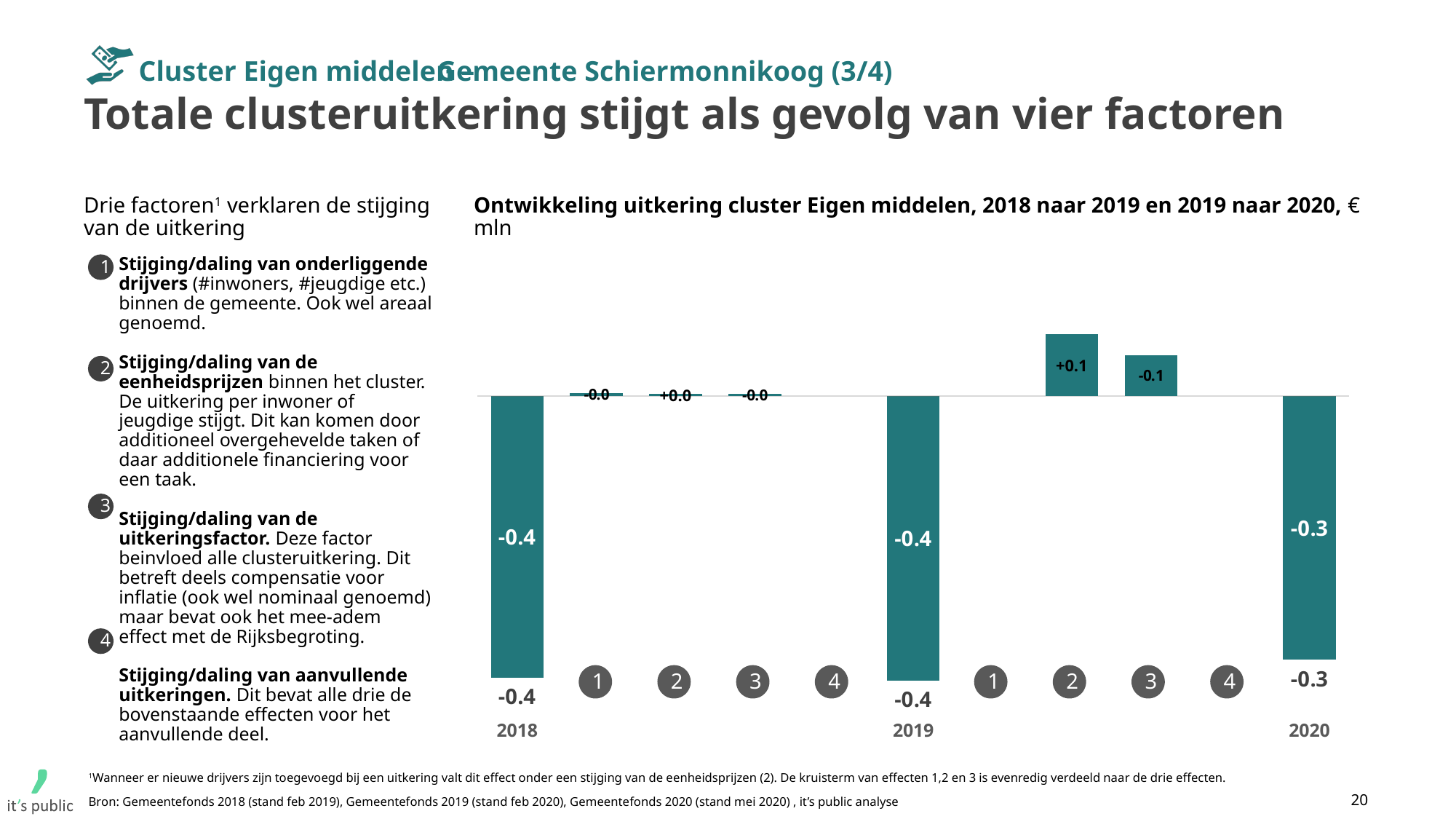
What is the value labelled for factor 2 in the 2018 to 2019 step of the chart? +0.0 What is the value of the 2019 bar in the chart? -0.4 What kind of chart is shown on the slide? Bar chart What is the value of the 2018 bar in the chart? -0.4 What is the value labelled for factor 2 in the 2019 to 2020 step of the chart? +0.1 What unit is stated in the chart title? € mln What is the value labelled for factor 3 in the 2019 to 2020 step of the chart? -0.1 What is the difference between the 2020 value and the 2019 value in the chart? 0.1 Which year bar in the chart has the highest value? 2020 How many year bars (2018, 2019, 2020) are shown in the chart? 3 Which is larger in the chart, the 2020 value or the 2018 value? 2020 What is the value of the 2020 bar in the chart? -0.3